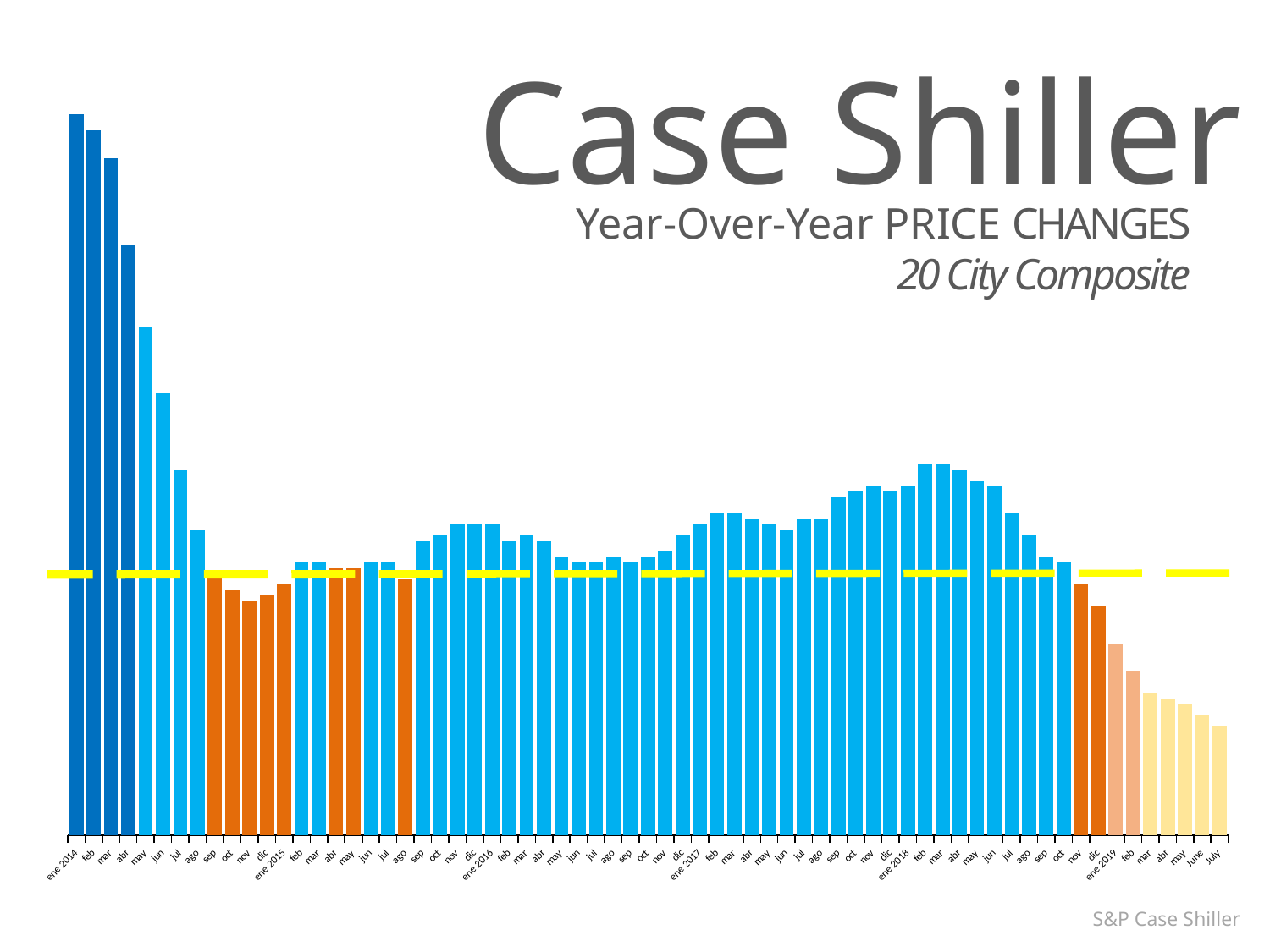
Which month has the highest bar in the chart? ene 2014 Which is higher, the bar for ene 2014 or the bar for ene 2019? ene 2014 Which is higher, the bar for ene 2014 or the bar for feb 2014? ene 2014 What is the first month shown on the x axis? ene 2014 Do the bars rise or fall from ene 2014 to ago 2014? fall What is the subtitle printed under the title 'Case Shiller'? Year-Over-Year PRICE CHANGES Do the bars rise or fall from ene 2019 to July 2019? fall Which is higher, the bar for mar 2017 or the bar for mar 2018? mar 2018 Which month has the lowest bar in the chart? July 2019 Do the bars rise or fall from sep 2017 to feb 2018? rise What kind of chart is shown on the slide? bar chart